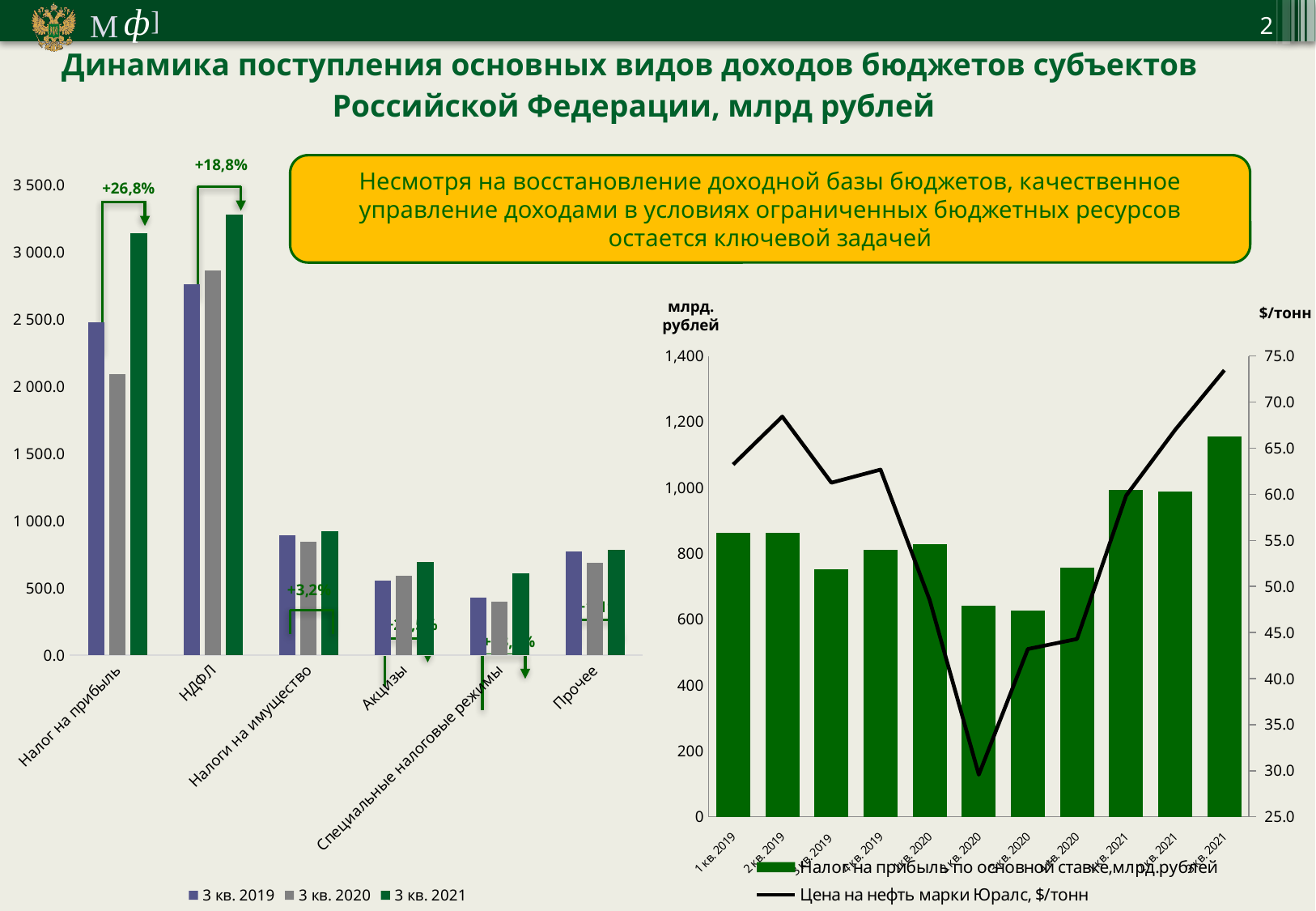
In the left chart, is the 3 кв. 2020 value for Налог на прибыль greater or less than 2 500.0? less In the left chart, what percentage change is annotated above the bars for Налог на прибыль? +26,8% In the right chart, in which quarter does the Цена на нефть марки Юралс line reach its lowest point? 2 кв. 2020 In the left chart, how many categories are shown on the x axis? 6 In the left chart, what percentage change is annotated above the bars for НДФЛ? +18,8% In the right chart, how many series does the legend list? 2 In the left chart, for Налог на прибыль, which is larger: the 3 кв. 2019 value or the 3 кв. 2020 value? 3 кв. 2019 In the left chart, which category has the lowest value for 3 кв. 2020? Специальные налоговые режимы What kind of chart is the chart on the left side of the slide? bar chart In the right chart, how many quarters (bars) are plotted? 11 In the left chart, how many series does the legend list? 3 In the right chart, which quarter has the highest bar for Налог на прибыль по основной ставке? 3 кв. 2021